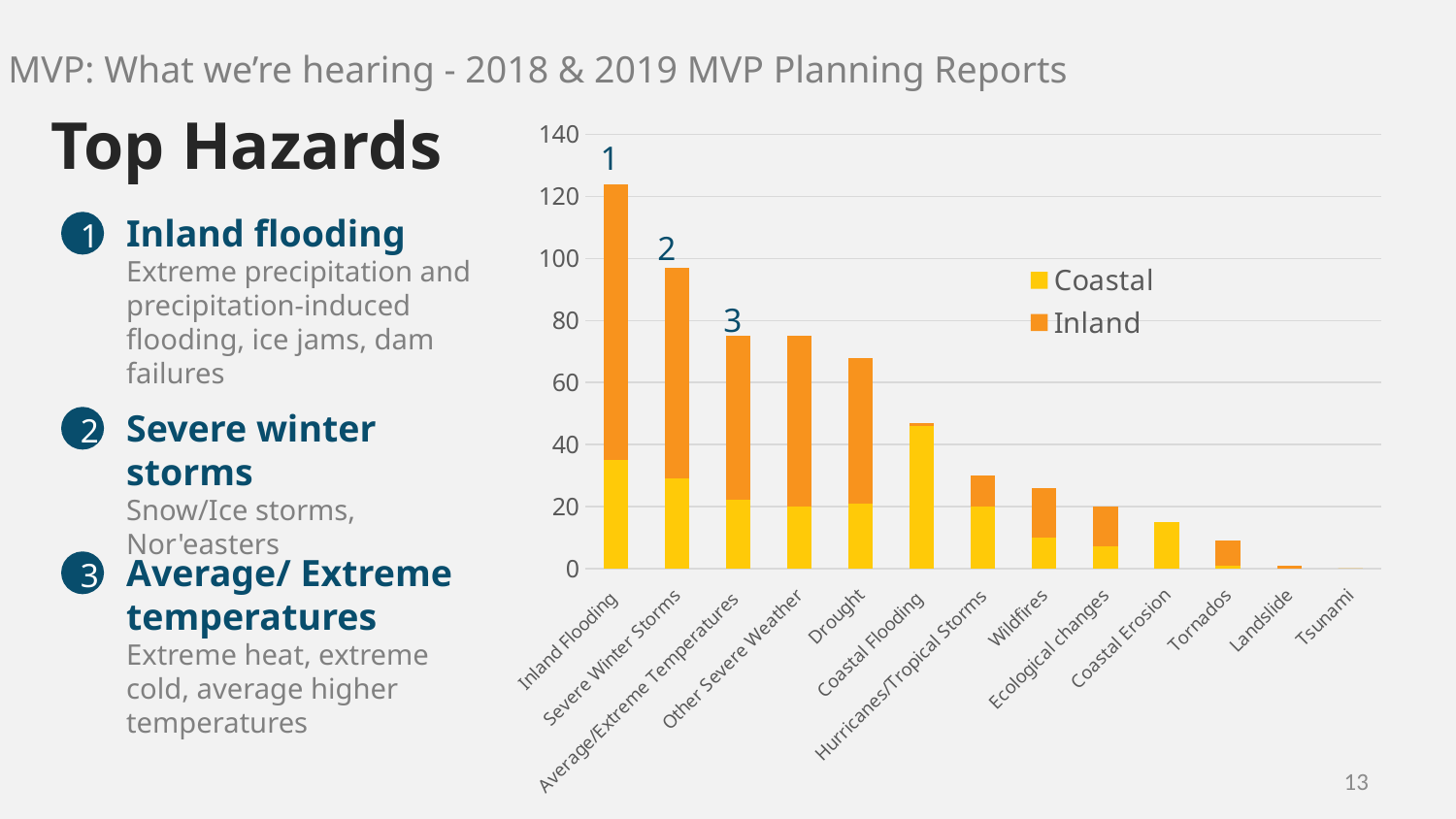
Is the total value for Drought greater or less than 60? greater Which colour represents the Coastal series in the chart's legend? Yellow Do the bar totals rise or fall moving from left to right along the x axis? Fall Which hazard category has the smallest bar in the chart? Tsunami Is the total value for Severe Winter Storms greater or less than 100? less How many hazard categories are plotted along the x axis of the chart? 13 What kind of chart is shown on the slide? Stacked bar chart Is the total value for Inland Flooding greater or less than 120? greater Which hazard category has the tallest bar in the chart? Inland Flooding How many series does the chart's legend list? 2 Which has the larger total bar, Drought or Coastal Flooding? Drought